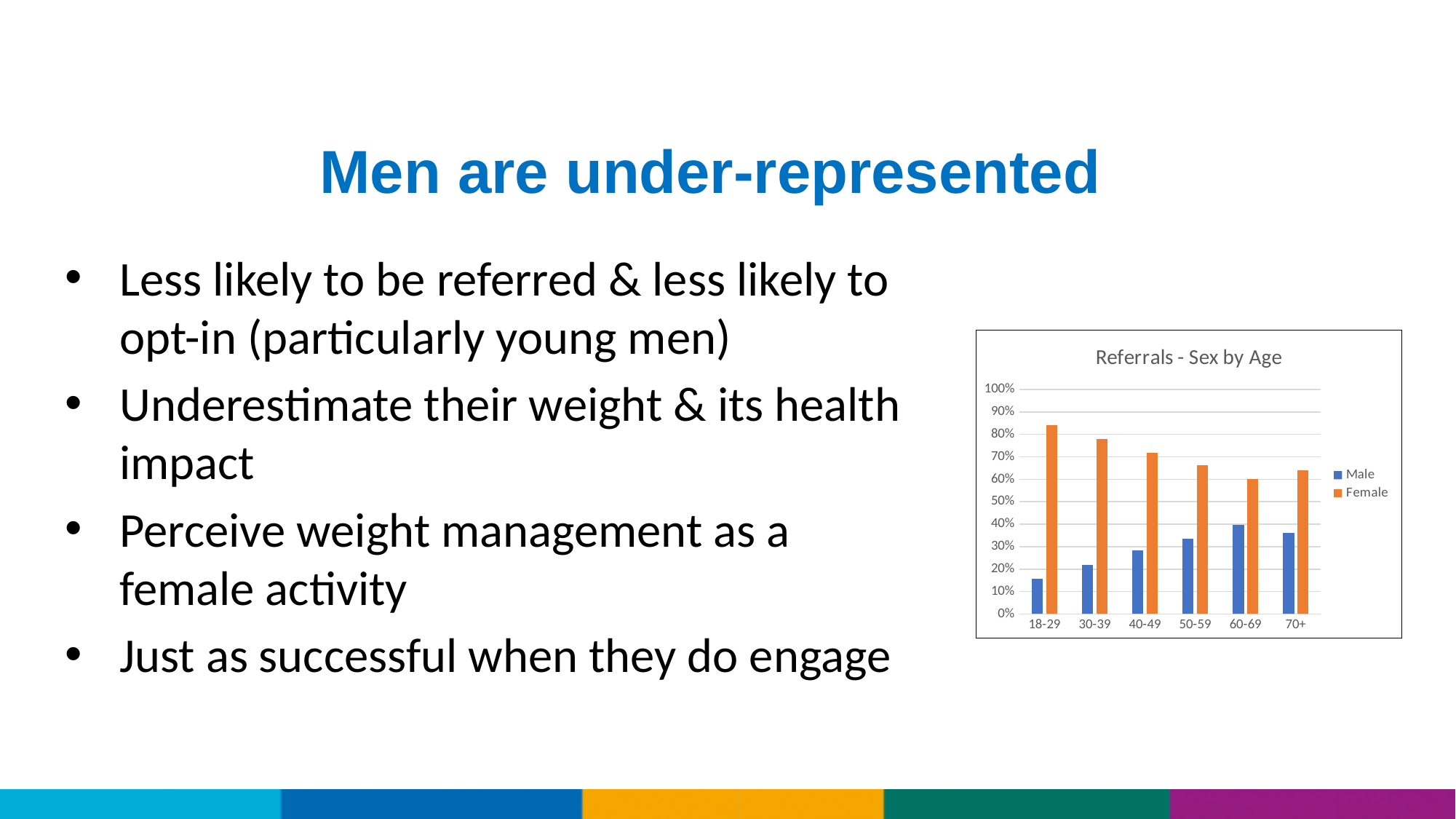
Is the Male value for 18-29 greater or less than 20%? less Is the Male value for 60-69 greater or less than 30%? greater What kind of chart is shown on the slide? Bar chart Which age group has the highest Male value? 60-69 What is the title of the chart on the slide? Referrals - Sex by Age Is the Female value for 18-29 greater or less than 80%? greater Which age group has the lowest Male value? 18-29 Which age group has the highest Female value? 18-29 How many age groups are shown on the x axis of the chart? 6 Do the Male values rise or fall from 18-29 to 60-69? rise In the 50-59 age group, which is larger, the Male or the Female value? Female How many series does the chart's legend list? 2